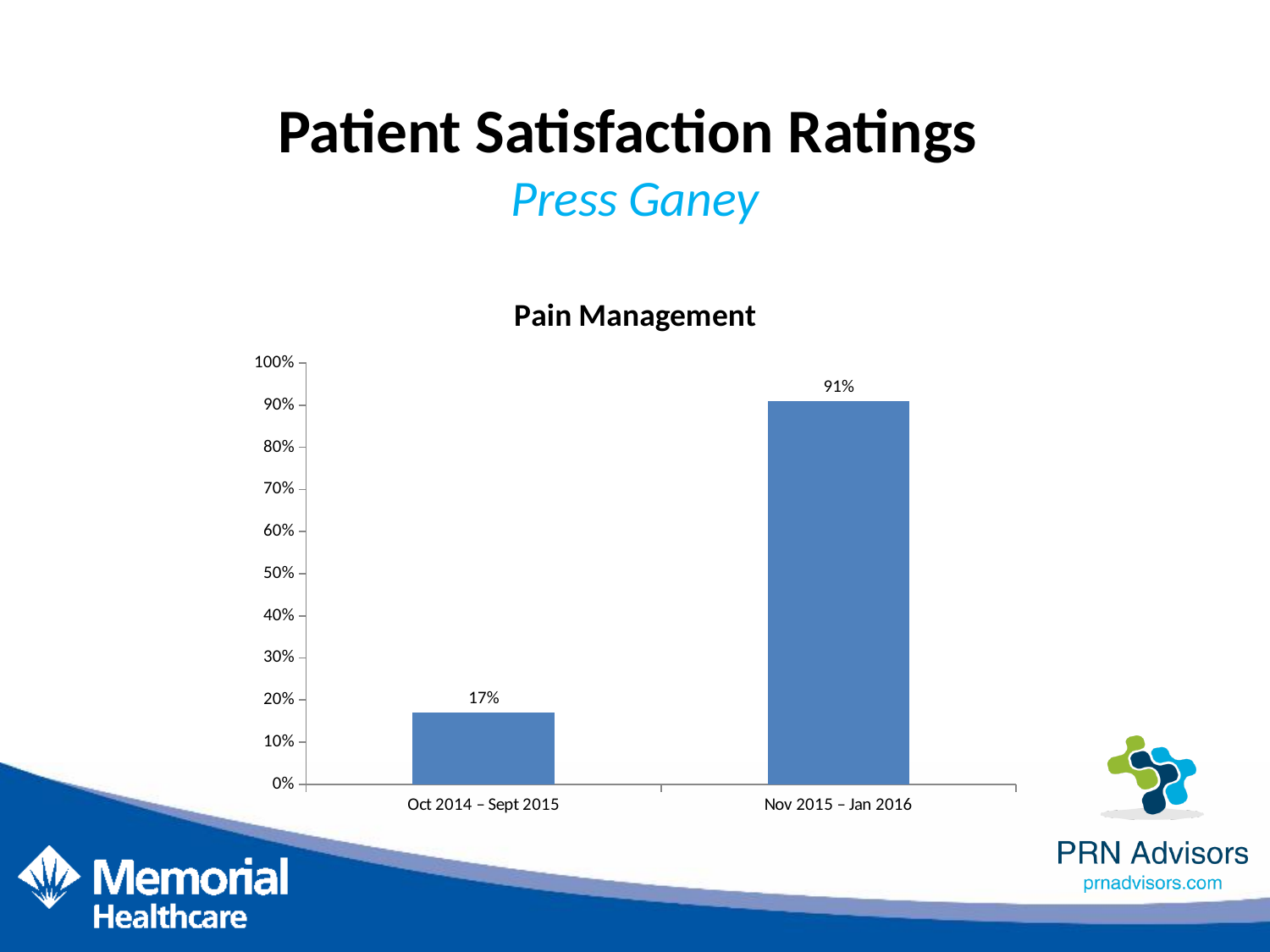
Is the value for Nov 2015 – Jan 2016 greater or less than 80%? greater How many periods are shown on the x axis of the chart? 2 What kind of chart is shown on the slide? bar chart What is the title of the chart? Pain Management What is the Pain Management value for Oct 2014 – Sept 2015? 17% Is the value for Oct 2014 – Sept 2015 greater or less than 20%? less Which period has the highest Pain Management rating? Nov 2015 – Jan 2016 Which period has the lowest Pain Management rating? Oct 2014 – Sept 2015 What is the Pain Management value for Nov 2015 – Jan 2016? 91% Which is larger, the value for Oct 2014 – Sept 2015 or the value for Nov 2015 – Jan 2016? Nov 2015 – Jan 2016 Do the values rise or fall from the first period to the second? rise What is the difference between the Nov 2015 – Jan 2016 and Oct 2014 – Sept 2015 values? 74%